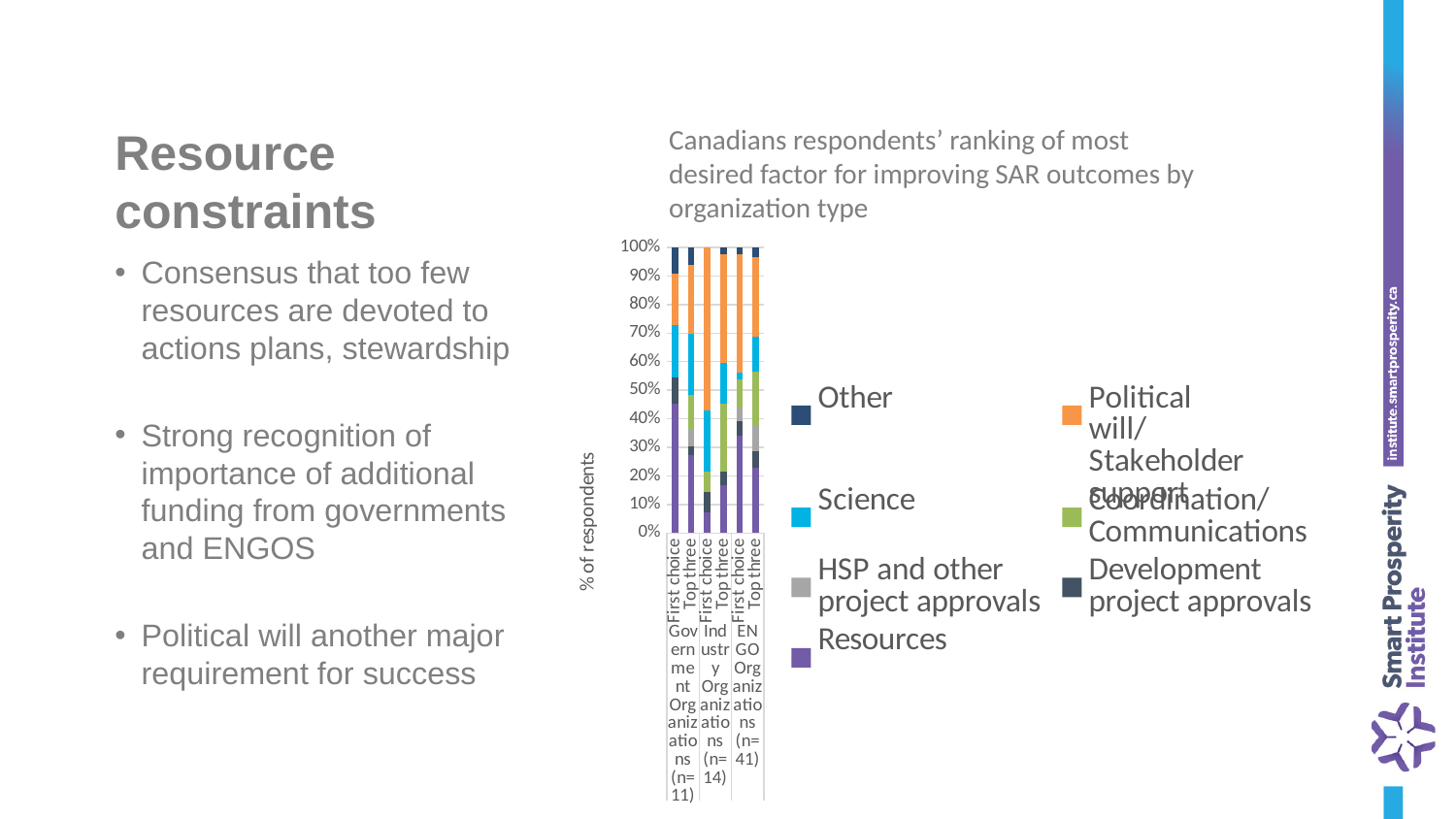
What is the total height of each stacked bar in the chart? 100% How many bars are plotted in the chart? 6 Is the Resources share for Government Organizations' First choice greater or less than 30%? greater Is the Political will/Stakeholder support share for Industry Organizations' First choice greater or less than 30%? greater What kind of chart is shown on the slide? Stacked bar chart How many series does the chart's legend list? 7 What is the label on the chart's vertical axis? % of respondents Is the Resources share for Industry Organizations' First choice greater or less than 30%? less What is the title of the chart? Canadians respondents' ranking of most desired factor for improving SAR outcomes by organization type Which organization type has the largest sample size (n) shown on the chart's category axis? ENGO Organizations (n=41) Which has a larger Resources segment: Government Organizations' First choice or Industry Organizations' First choice? Government Organizations' First choice Which organization type has the smallest sample size (n) shown on the chart's category axis? Government Organizations (n=11)